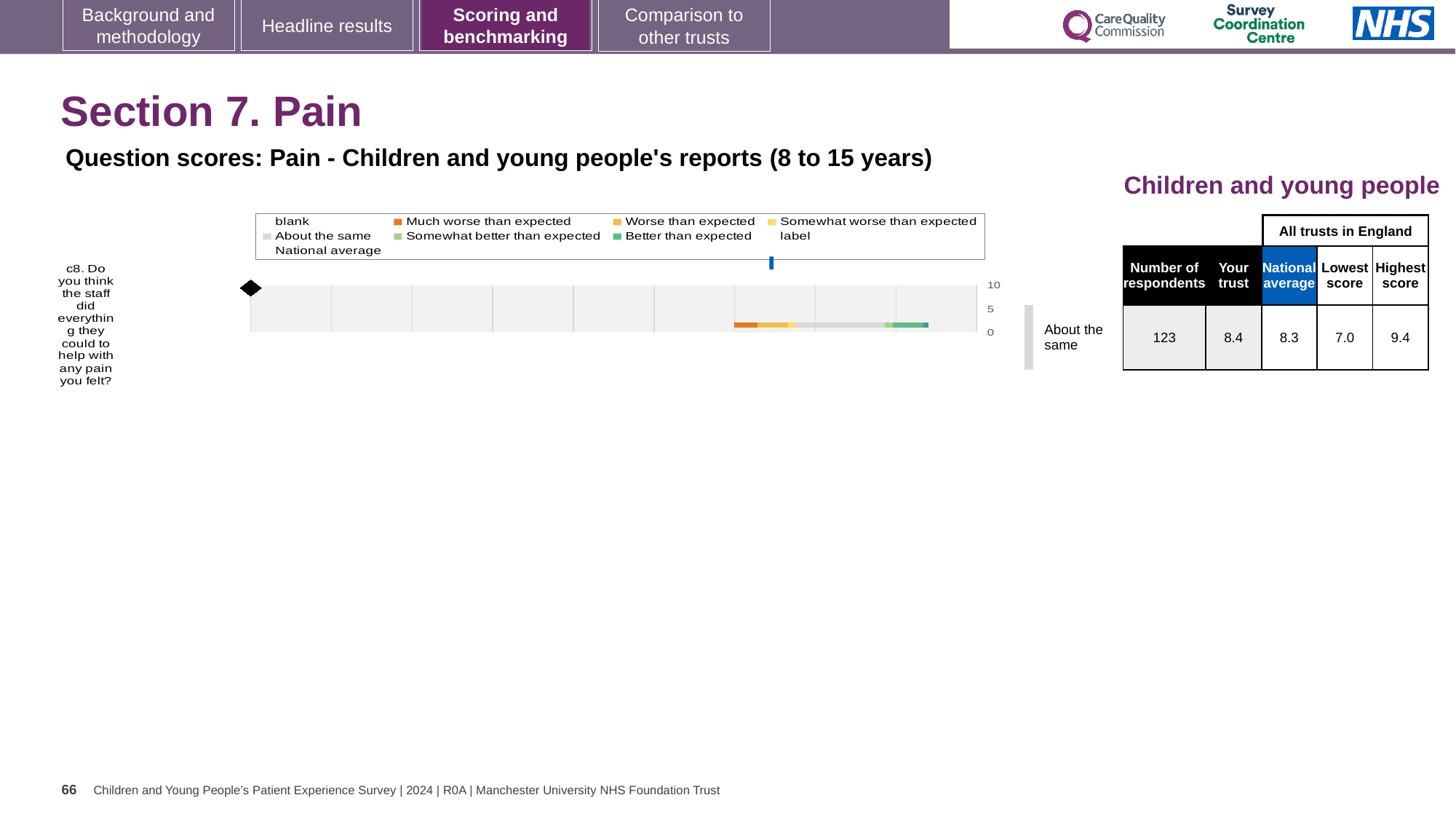
In the table to the right of the chart, what is the National average score? 8.3 In the table to the right of the chart, what is the difference between the Highest score and the Lowest score? 2.4 Which question is plotted on the chart? c8. Do you think the staff did everything they could to help with any pain you felt? In the table to the right of the chart, which is larger, the Your trust score or the National average score? Your trust What is the highest value shown on the chart's axis? 10 What kind of chart is shown on the slide? bar chart How many question categories are plotted on the chart? 1 In the table to the right of the chart, what is the Number of respondents for the 'About the same' row? 123 In the table to the right of the chart, what is the Highest score among all trusts in England? 9.4 In the table to the right of the chart, what is the Your trust score? 8.4